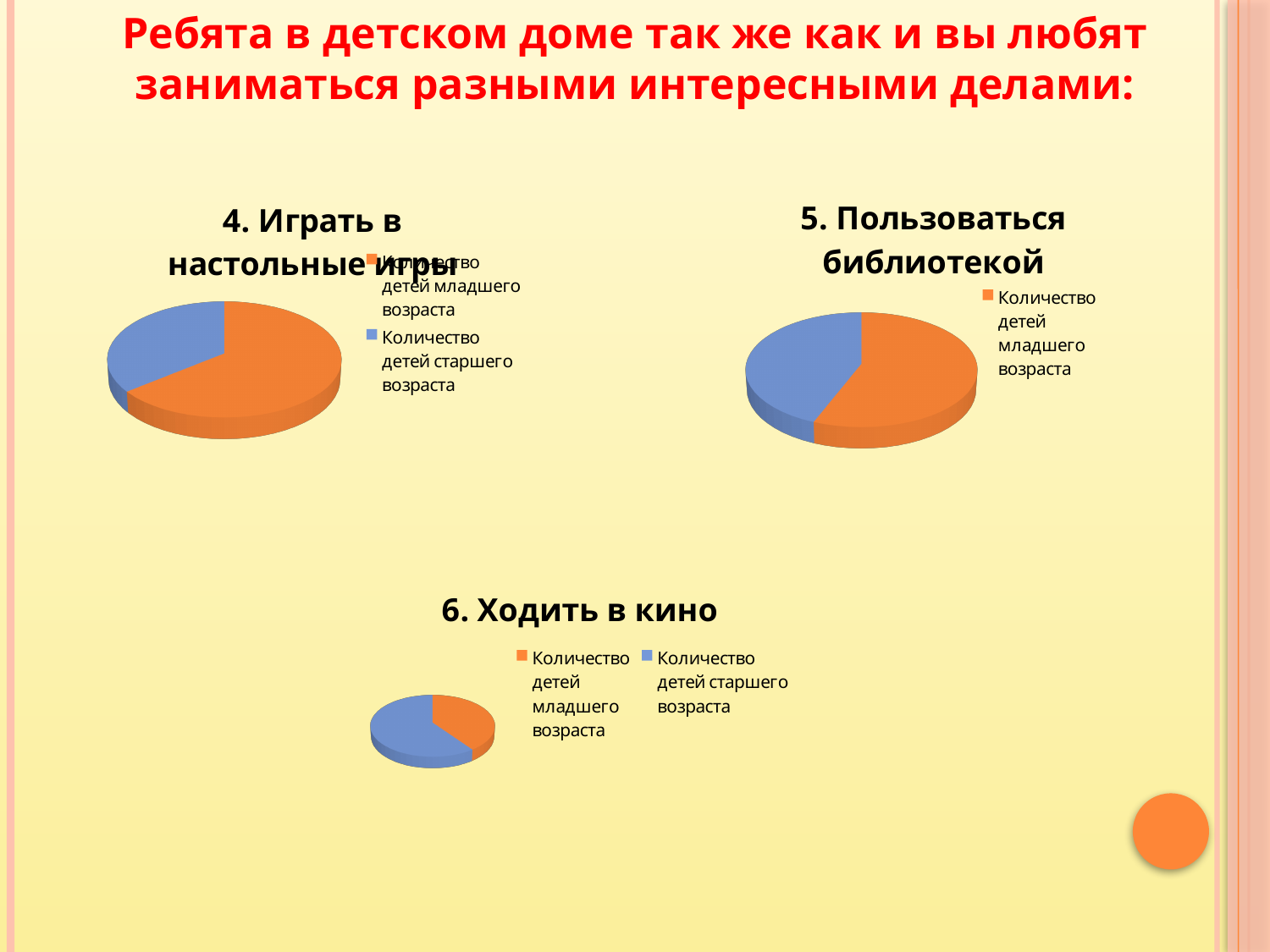
How many entries does the legend of the chart titled "6. Ходить в кино" list? 2 In the chart titled "6. Ходить в кино", what colour is the slice for "Количество детей старшего возраста"? blue How many slices does the pie in the chart titled "6. Ходить в кино" have? 2 In the chart titled "6. Ходить в кино", which category has the smallest slice? Количество детей младшего возраста What kind of chart is the chart titled "4. Играть в настольные игры"? pie chart In the chart titled "4. Играть в настольные игры", which slice is larger: "Количество детей младшего возраста" or "Количество детей старшего возраста"? Количество детей младшего возраста How many slices does the pie in the chart titled "4. Играть в настольные игры" have? 2 What kind of chart is the chart titled "6. Ходить в кино"? pie chart In the chart titled "6. Ходить в кино", which slice is larger: "Количество детей младшего возраста" or "Количество детей старшего возраста"? Количество детей старшего возраста In the chart titled "4. Играть в настольные игры", which category has the largest slice? Количество детей младшего возраста How many pie charts are shown on the slide? 3